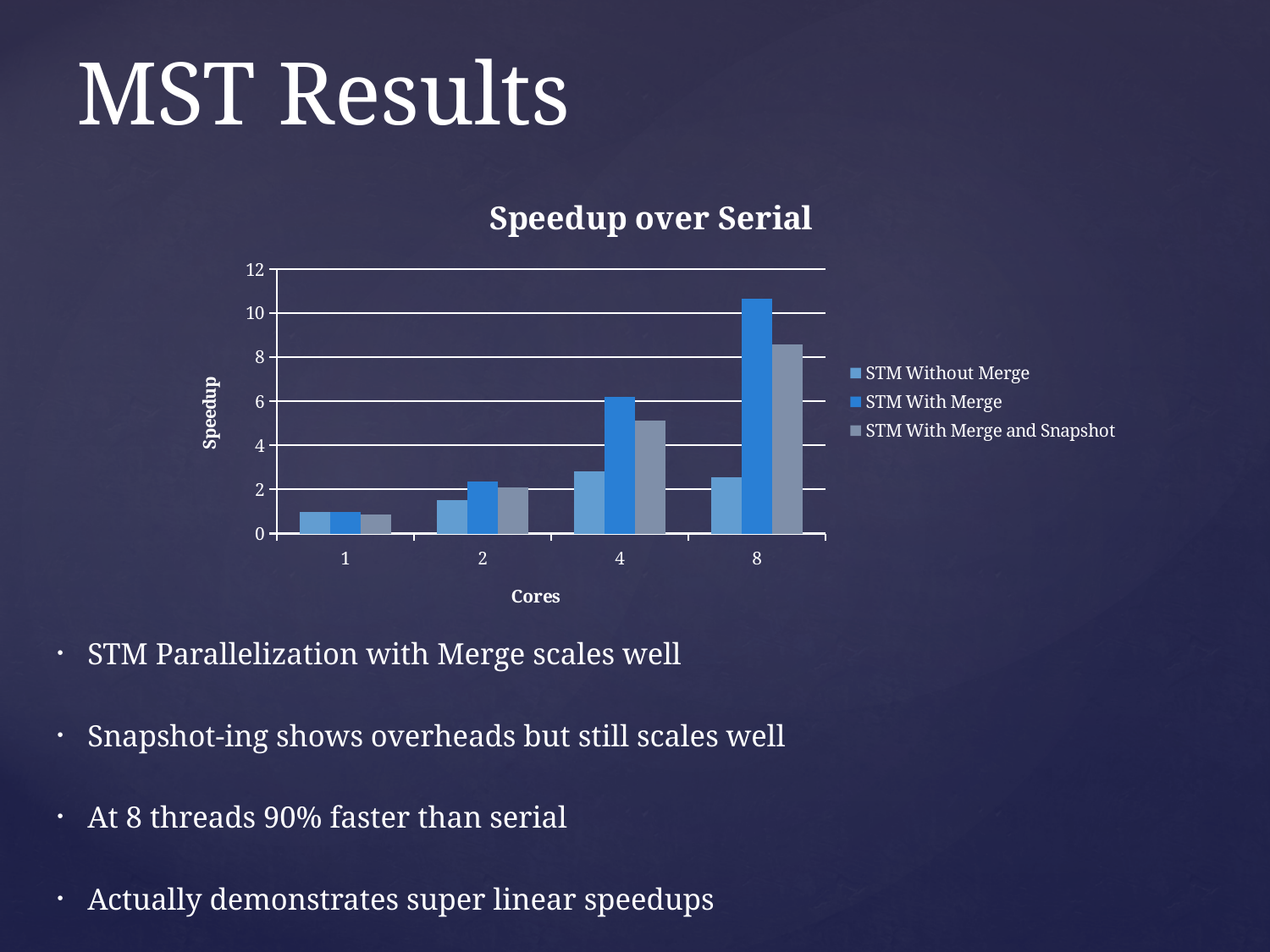
How many core counts are shown along the x axis of the chart? 4 What is the title of the chart? Speedup over Serial What is the label of the x axis of the chart? Cores Is the speedup for STM With Merge at 8 cores greater or less than 10? greater At 4 cores, which is larger: the speedup for STM With Merge or for STM With Merge and Snapshot? STM With Merge What kind of chart is shown on the slide? bar chart Is the speedup for STM With Merge and Snapshot at 8 cores greater or less than 8? greater Which series has the lowest speedup at 8 cores? STM Without Merge Is the speedup for STM Without Merge at 8 cores greater or less than 4? less Which series has the highest speedup at 8 cores? STM With Merge How many series does the chart's legend list? 3 Does the speedup for STM With Merge rise or fall as the number of cores increases from 1 to 8? rise